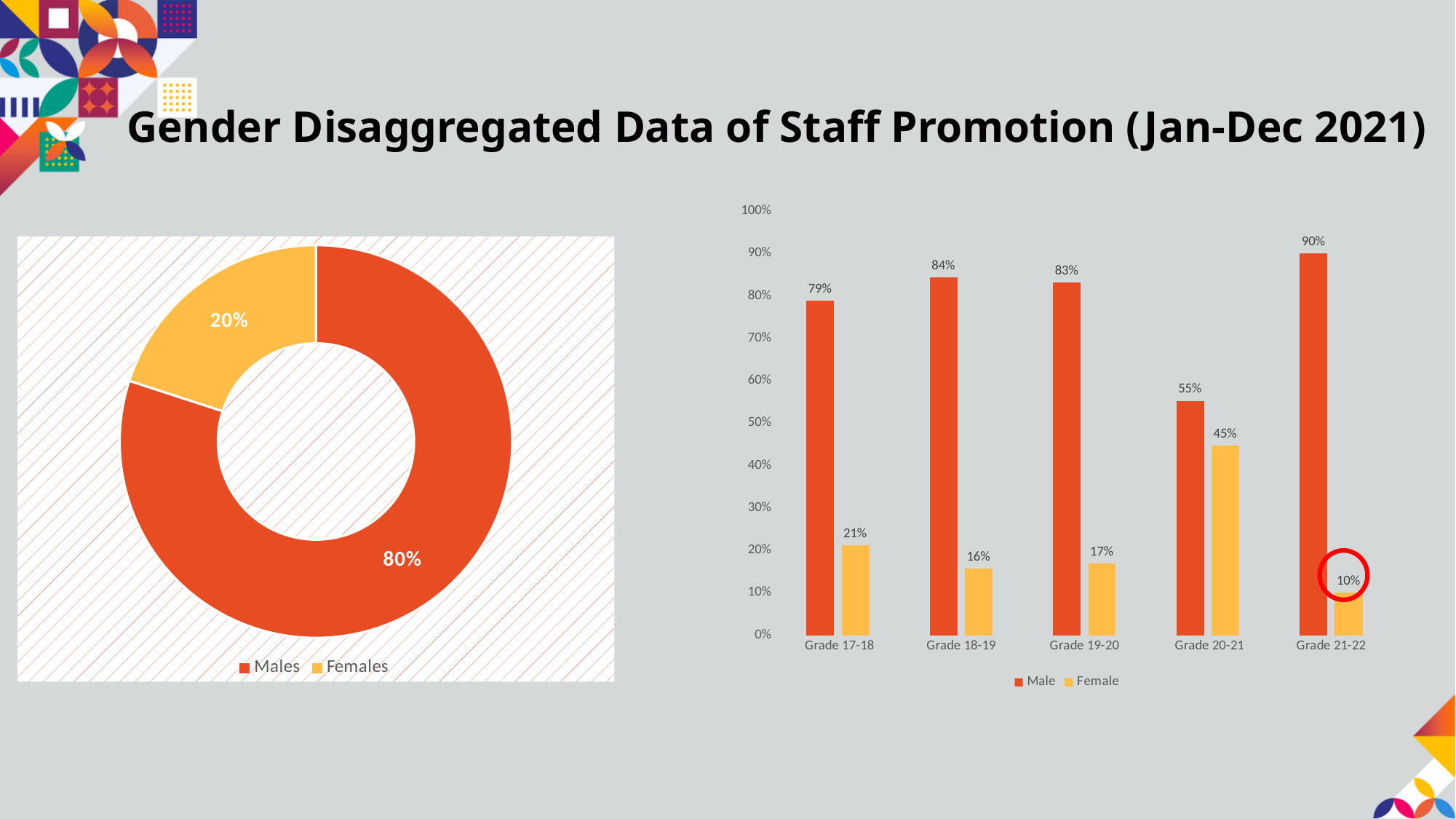
How many grade categories are shown in the bar chart on the right? 5 In the bar chart on the right, what is the Male value for Grade 18-19? 84% In the bar chart on the right, what is the difference between the Male and Female values for Grade 17-18? 58% In the doughnut chart on the left, what share of promotions went to Males? 80% In the bar chart on the right, what is the Female value for Grade 20-21? 45% What kind of chart is the chart on the left of the slide? Doughnut (pie) chart In the bar chart on the right, which grade has the lowest Female value? Grade 21-22 In the doughnut chart on the left, what share of promotions went to Females? 20% In the bar chart on the right, is the Female value for Grade 18-19 or Grade 19-20 larger? Grade 19-20 In the bar chart on the right, which grade has the highest Male value? Grade 21-22 What kind of chart is the chart on the right of the slide? Bar chart How many series does the legend of the bar chart on the right list? 2